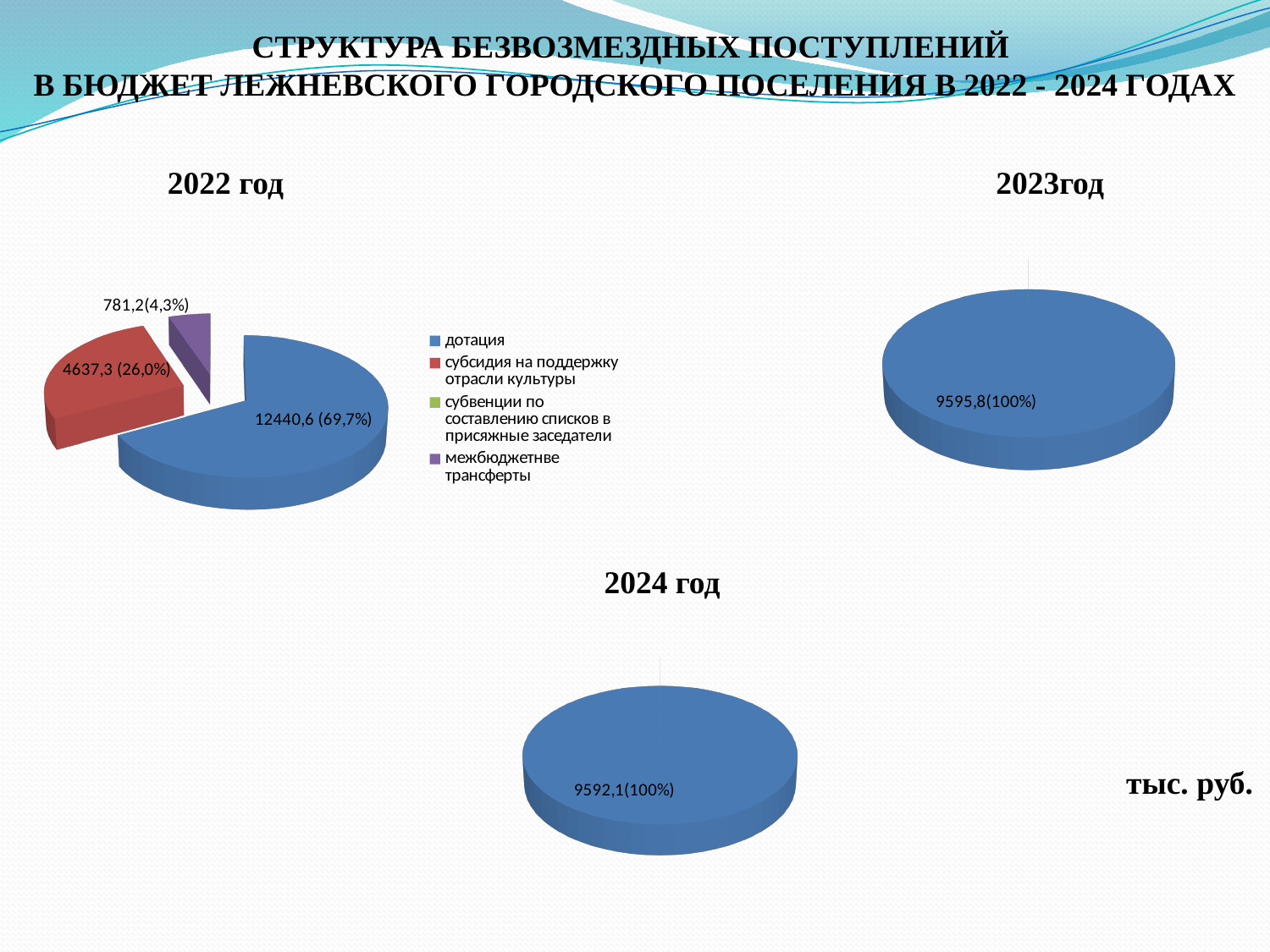
In the 2022 год chart, what share of the pie does субсидия на поддержку отрасли культуры take? 26,0% In the 2022 год chart, which is larger: дотация or субсидия на поддержку отрасли культуры? дотация In the 2022 год chart, what is the value shown for субсидия на поддержку отрасли культуры? 4637,3 (26,0%) What kind of chart is used for the 2022 год data? pie chart What value is shown on the 2023год chart? 9595,8(100%) In the 2022 год chart, what is the value shown for дотация? 12440,6 (69,7%) In the 2022 год chart, what is the value shown for межбюджетнве трансферты? 781,2(4,3%) In the 2022 год chart, which category has the largest slice? дотация What value is shown on the 2024 год chart? 9592,1(100%) How many pie charts are on the slide? 3 In the 2022 год chart, which labelled slice is the smallest? межбюджетнве трансферты How many entries does the legend of the 2022 год chart list? 4